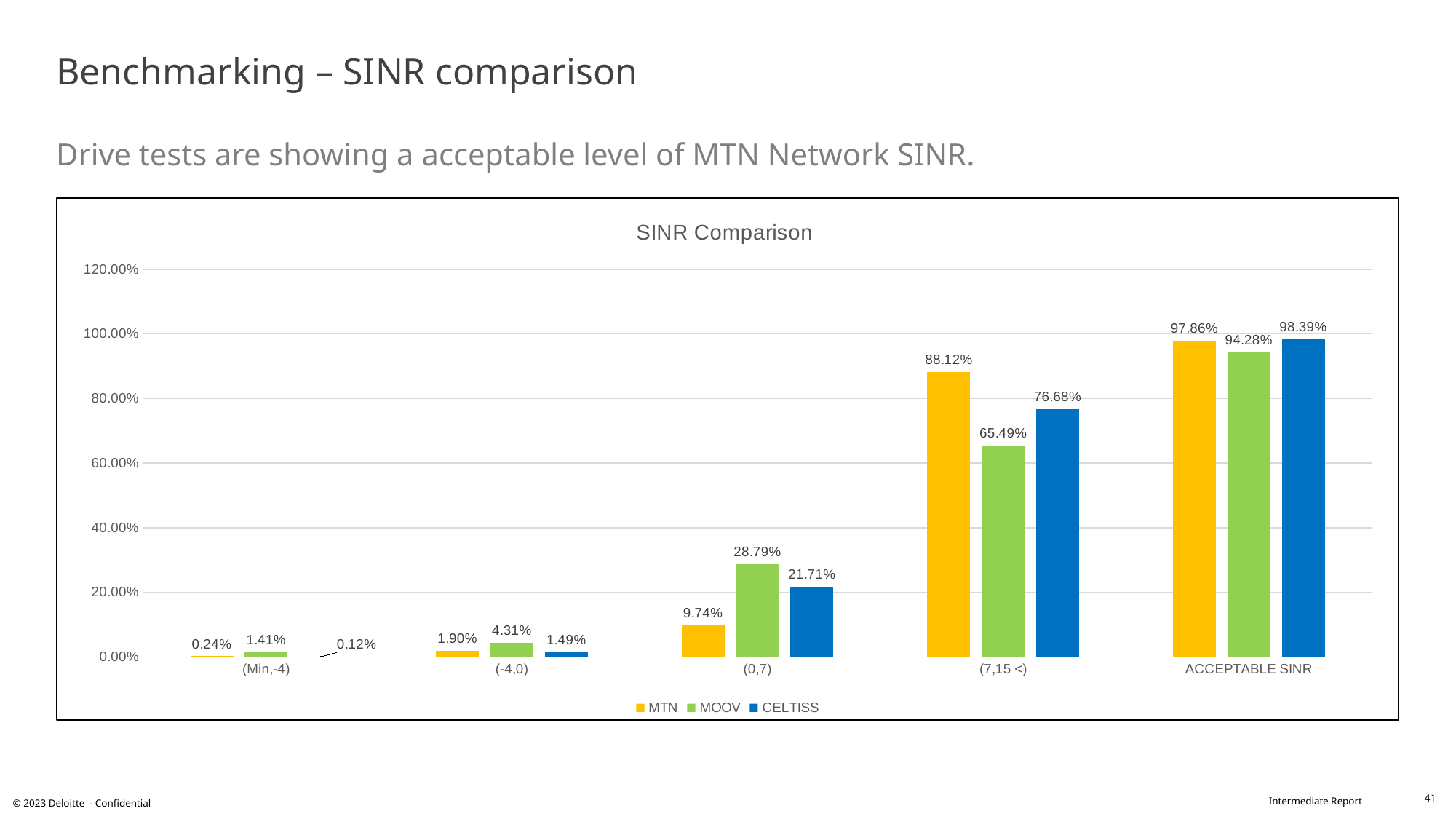
Which series has the lowest value in the (Min,-4) category? CELTISS How many categories are shown on the x axis? 5 What is the value for CELTISS in the ACCEPTABLE SINR category? 98.39% What kind of chart is shown? Bar chart Is the value for CELTISS in the (7,15 <) category greater or less than 80.00%? less Which series has the highest value in the (7,15 <) category? MTN What is the value for MTN in the (7,15 <) category? 88.12% What is the difference between the MTN and MOOV values in the (7,15 <) category? 22.63% What is the value for MOOV in the (0,7) category? 28.79% How many series does the legend list? 3 What is the value for MTN in the (-4,0) category? 1.90% Which is larger in the ACCEPTABLE SINR category, MTN or MOOV? MTN